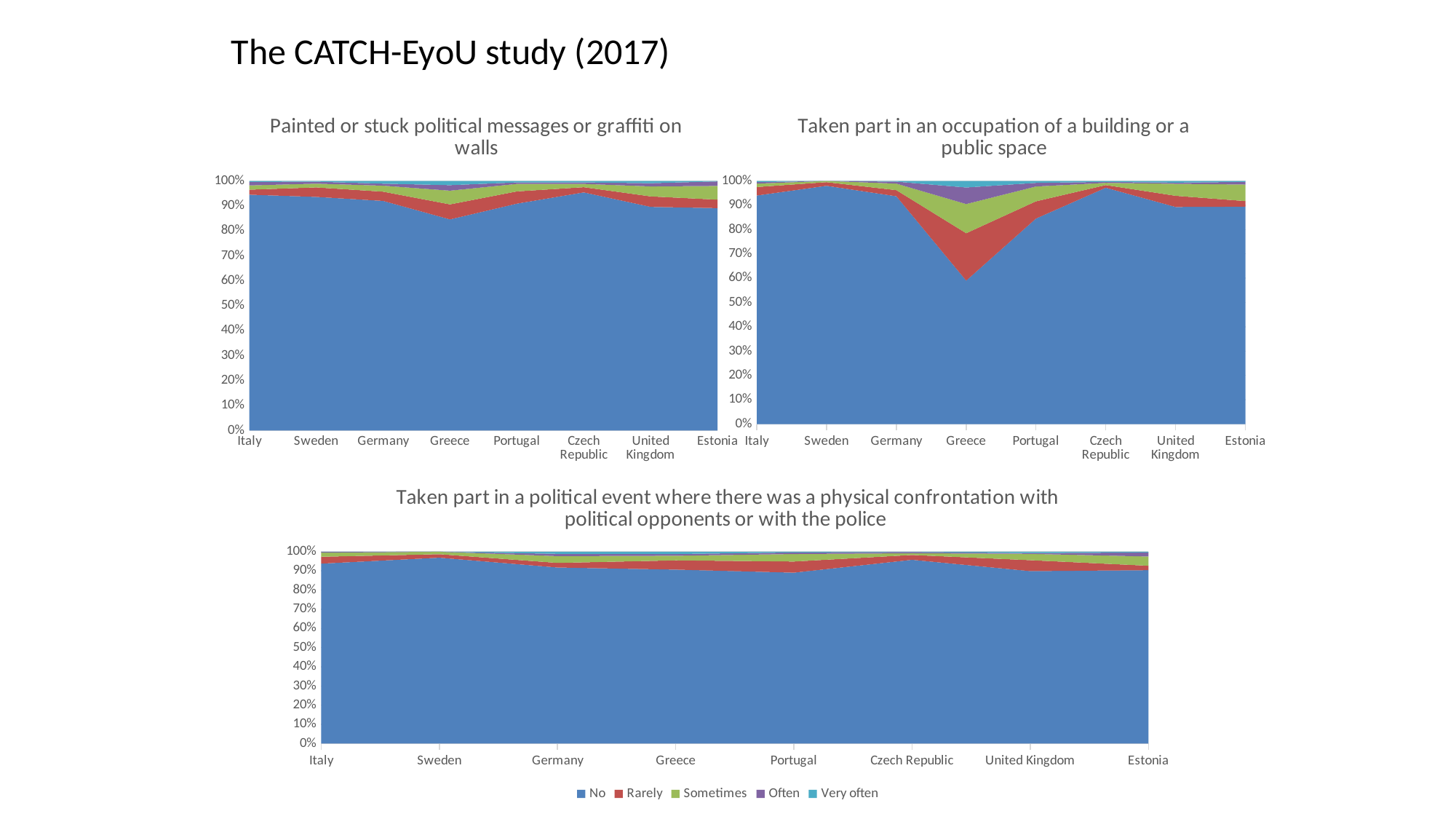
Which series is shown in blue in the legend? No In the 'Painted or stuck political messages or graffiti on walls' chart, which country has the lowest share of 'No' responses? Greece What is the title of the chart at the bottom of the slide? Taken part in a political event where there was a physical confrontation with political opponents or with the police In the 'Taken part in an occupation of a building or a public space' chart, which country has the lowest share of 'No' responses? Greece In the 'Painted or stuck political messages or graffiti on walls' chart, is the 'No' share for Italy greater or less than 90%? greater In the 'Painted or stuck political messages or graffiti on walls' chart, is the 'No' share for Greece greater or less than 90%? less In the 'Taken part in an occupation of a building or a public space' chart, is the 'No' share for Greece greater or less than 70%? less How many series does the legend list on the slide? 5 What kind of chart is the 'Painted or stuck political messages or graffiti on walls' chart? Stacked area chart In the 'Taken part in an occupation of a building or a public space' chart, which country has a larger 'No' share, Greece or Portugal? Portugal How many countries are shown on the x axis of the 'Taken part in an occupation of a building or a public space' chart? 8